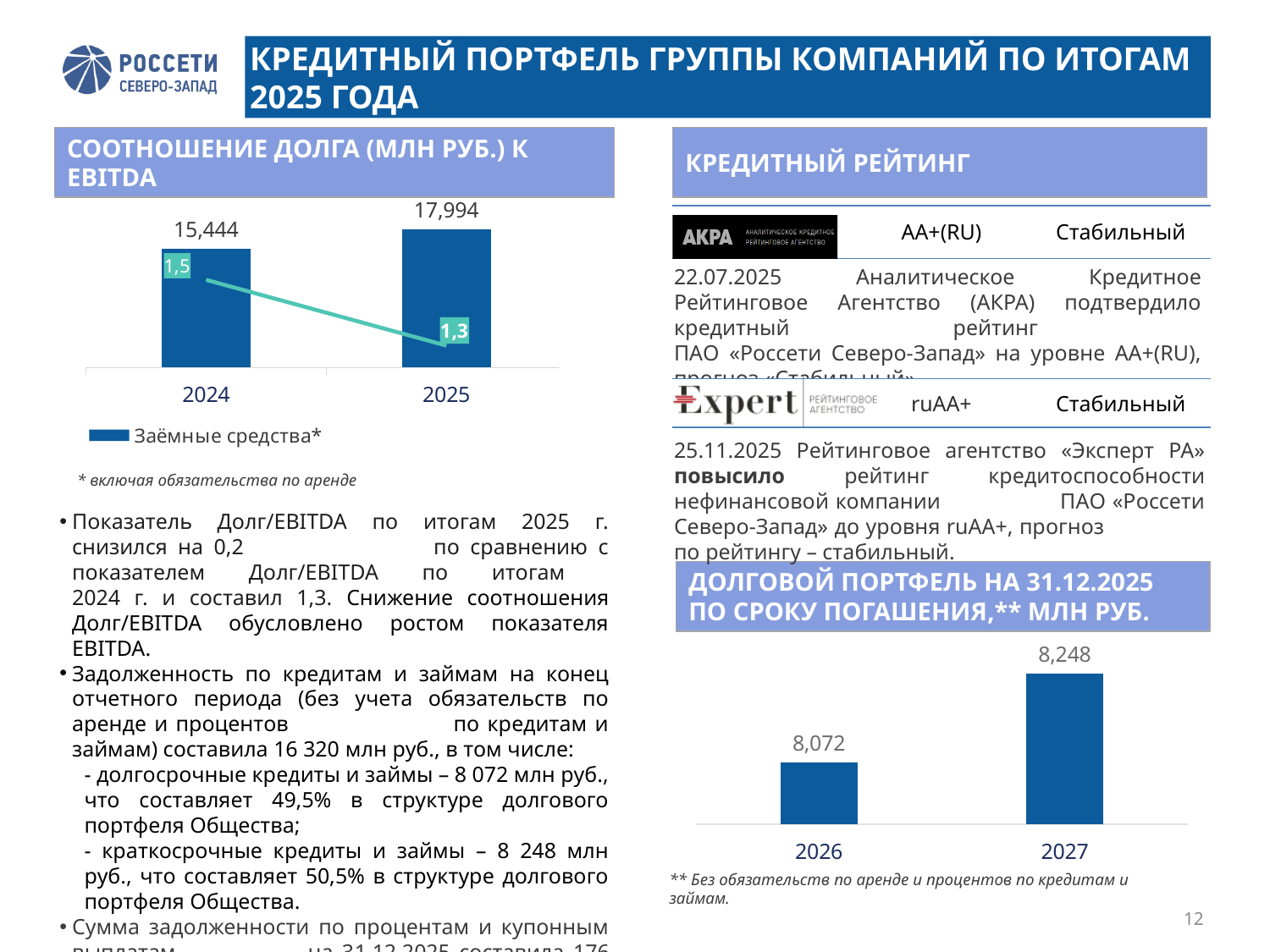
In the chart 'Соотношение долга (млн руб.) к EBITDA', how many entries does the legend list? 1 In the chart 'Долговой портфель на 31.12.2025 по сроку погашения', how many years are shown on the x axis? 2 In the chart 'Долговой портфель на 31.12.2025 по сроку погашения', what is the difference between the 2027 and 2026 values? 176 In the chart 'Соотношение долга (млн руб.) к EBITDA', by how much did Заёмные средства increase from 2024 to 2025? 2,550 In the chart 'Соотношение долга (млн руб.) к EBITDA', what is the Долг/EBITDA ratio shown on the line for 2025? 1,3 In the chart 'Соотношение долга (млн руб.) к EBITDA', what is the value of Заёмные средства for 2025? 17,994 In the chart 'Соотношение долга (млн руб.) к EBITDA', does the line value rise or fall from 2024 to 2025? fall In the chart 'Долговой портфель на 31.12.2025 по сроку погашения', what is the value for 2027? 8,248 In the chart 'Долговой портфель на 31.12.2025 по сроку погашения', what is the value for 2026? 8,072 What type of chart is 'Долговой портфель на 31.12.2025 по сроку погашения'? bar chart In the chart 'Соотношение долга (млн руб.) к EBITDA', which year has the higher bar? 2025 In the chart 'Соотношение долга (млн руб.) к EBITDA', what is the value of Заёмные средства for 2024? 15,444